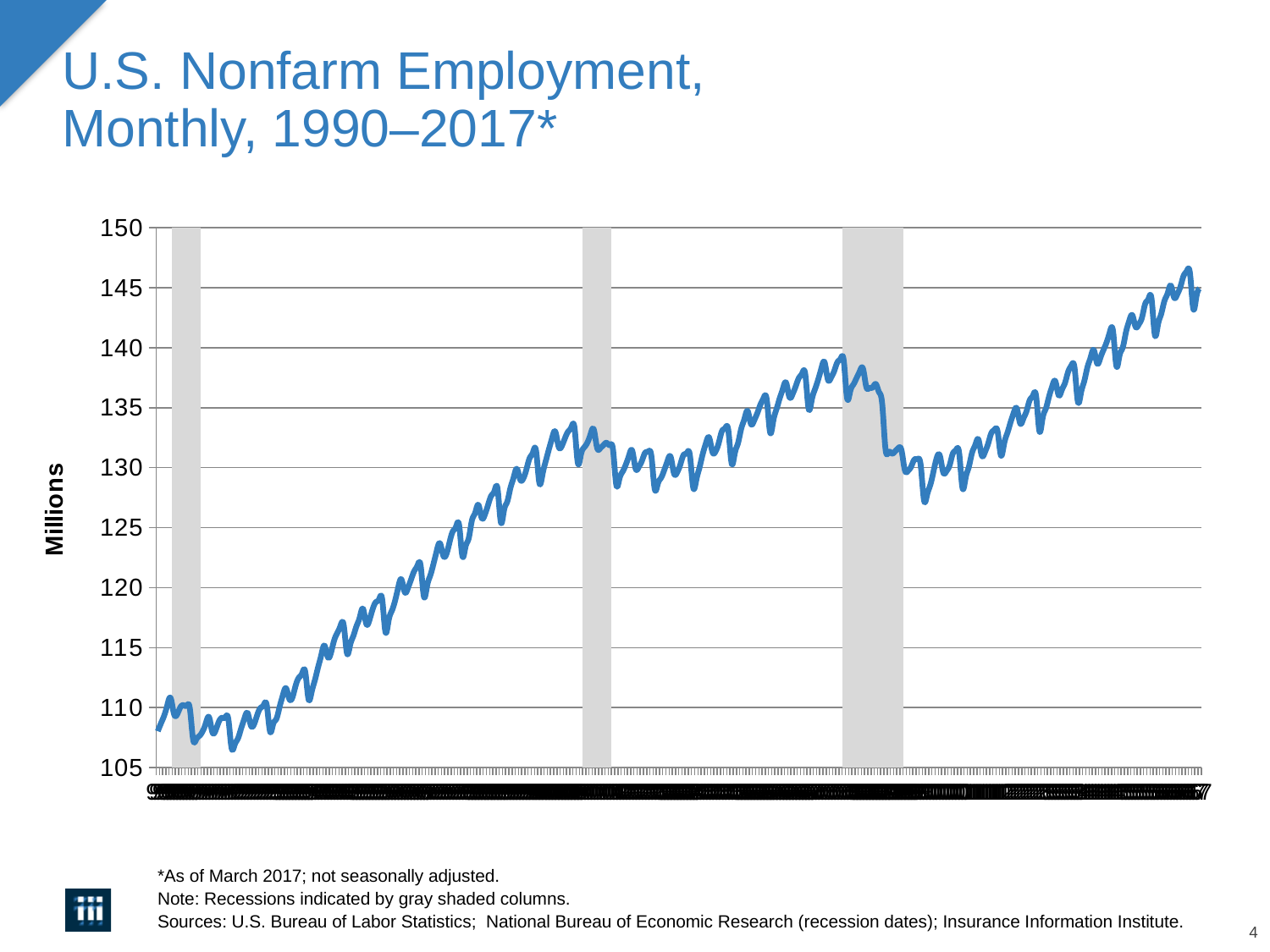
What kind of chart is shown on the slide? line chart Is the value at the end of the series larger or smaller than the value at the start of the series? larger Is the lowest value on the chart greater or less than 110? less Is the value at the end of the series (March 2017) greater or less than 140? greater Is the highest value reached on the chart greater or less than 150? less Overall, does U.S. nonfarm employment rise or fall from the start to the end of the series? rise What is the label on the vertical axis? Millions How many gray shaded recession columns are shown on the chart? 3